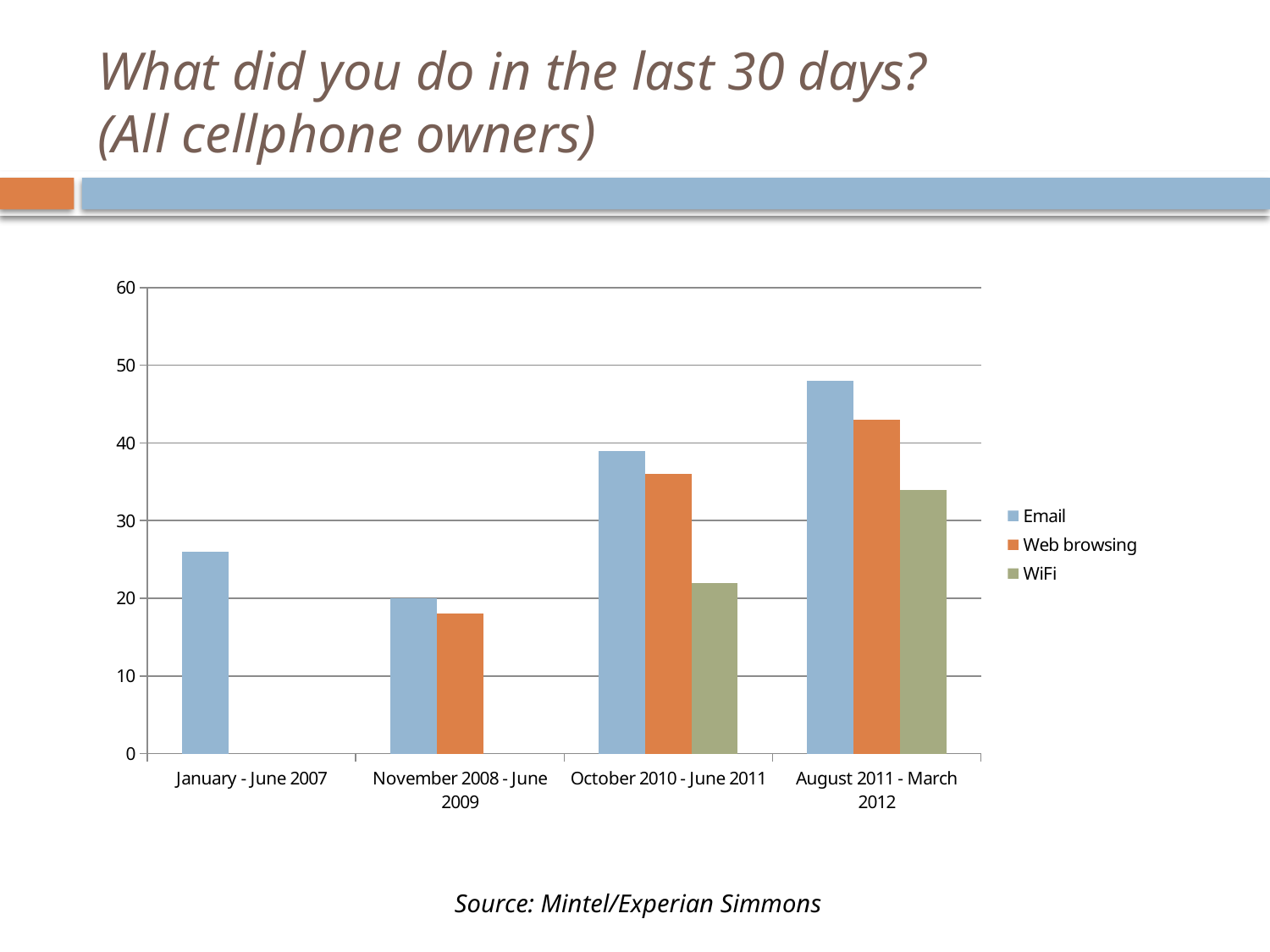
Is the WiFi value for October 2010 - June 2011 greater or less than 30? less How many series does the legend list? 3 Is the Email value for August 2011 - March 2012 greater or less than 40? greater How many time periods are shown on the x axis? 4 Which series is shown in orange in the legend? Web browsing Is the Web browsing value for November 2008 - June 2009 greater or less than 20? less Which time period has the highest Email value? August 2011 - March 2012 What kind of chart is shown on the slide? bar chart Which time period has the lowest Email value? November 2008 - June 2009 In October 2010 - June 2011, which is larger: Email or WiFi? Email Does the Email series rise or fall from November 2008 - June 2009 to August 2011 - March 2012? rise